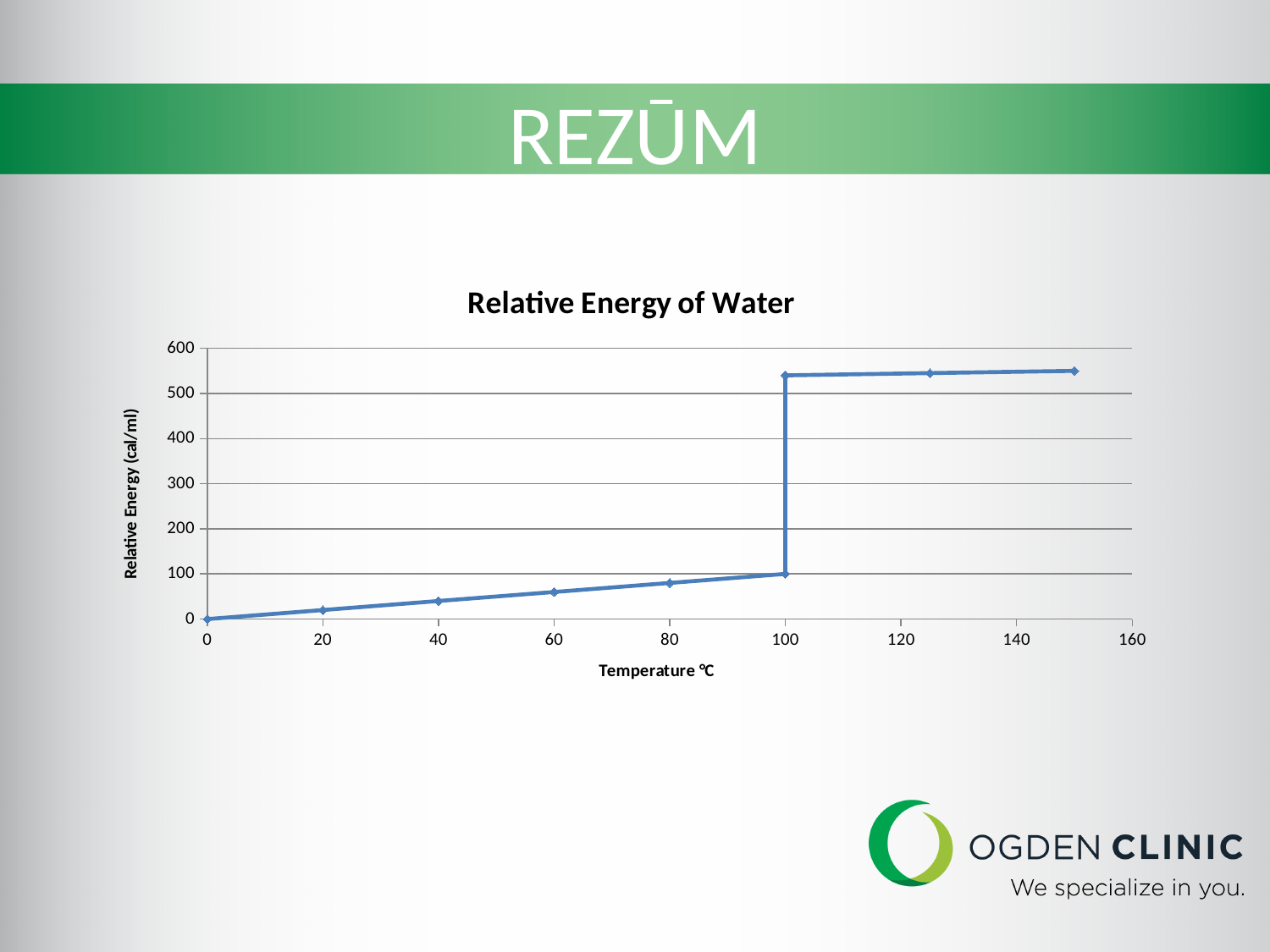
Which has the higher relative energy, 150 °C or 60 °C? 150 °C Is the relative energy at 80 °C greater or less than 100? less At what temperature does the relative energy jump sharply upward? 100 °C Does the relative energy rise or fall as temperature increases along the x axis? rise Is the relative energy at 40 °C greater or less than 100? less What kind of chart is shown on the slide? line chart What is the relative energy at 0 °C? 0 Is the relative energy at 150 °C greater or less than 500? greater What is the title of the chart? Relative Energy of Water Which has the higher relative energy, 20 °C or 80 °C? 80 °C